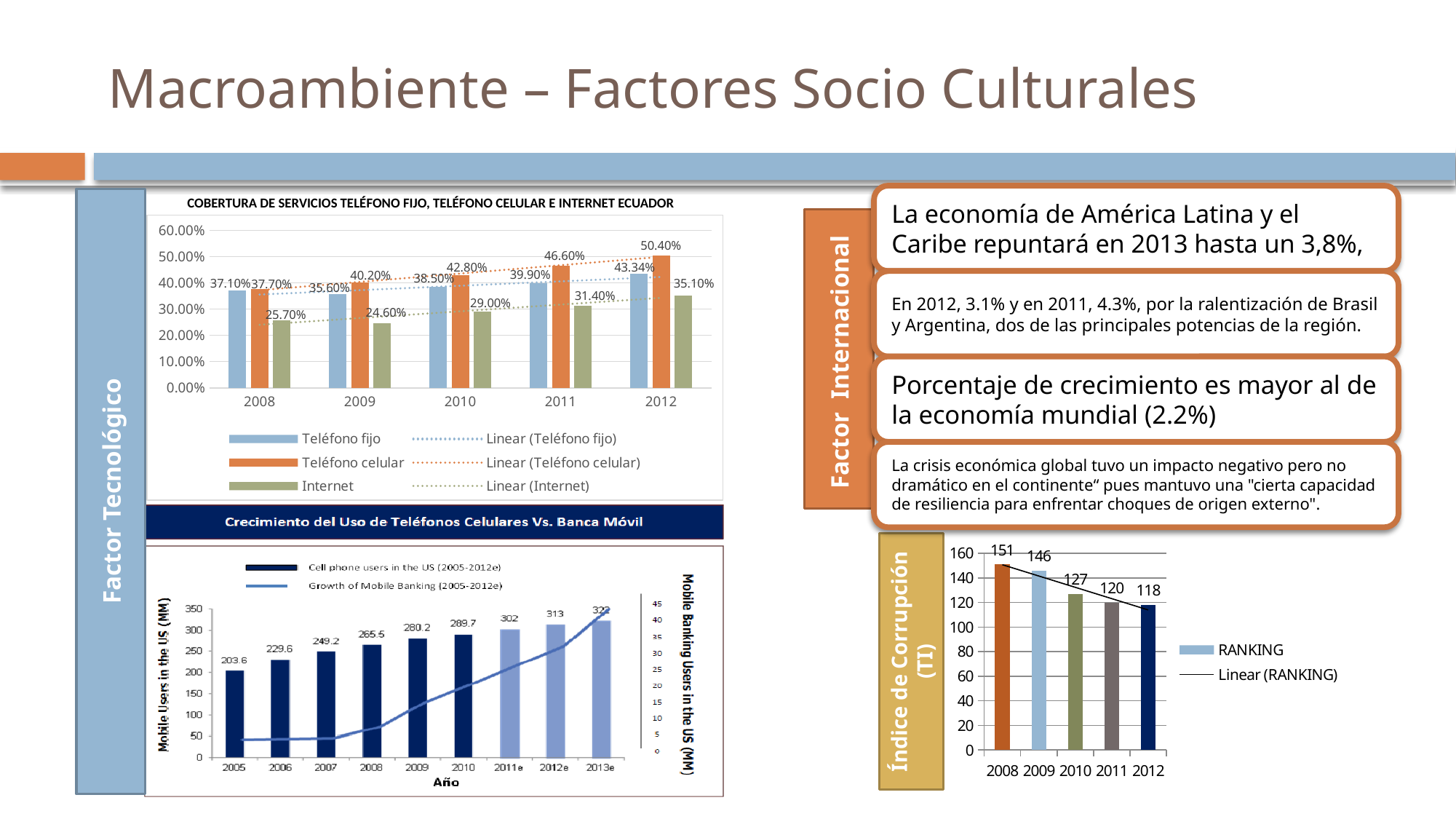
In the chart titled 'COBERTURA DE SERVICIOS TELÉFONO FIJO, TELÉFONO CELULAR E INTERNET ECUADOR', how many series does the legend list? 6 In the chart titled 'Crecimiento del Uso de Teléfonos Celulares Vs. Banca Móvil', how many years are shown on the x axis? 9 In the chart titled 'COBERTURA DE SERVICIOS TELÉFONO FIJO, TELÉFONO CELULAR E INTERNET ECUADOR', what is the value for Internet in 2009? 24.60% In the chart titled 'COBERTURA DE SERVICIOS TELÉFONO FIJO, TELÉFONO CELULAR E INTERNET ECUADOR', what is the value for Teléfono celular in 2012? 50.40% In the 'Índice de Corrupción (TI)' chart at the bottom right, what kind of chart is used for the RANKING series? bar chart In the chart titled 'COBERTURA DE SERVICIOS TELÉFONO FIJO, TELÉFONO CELULAR E INTERNET ECUADOR', does the Internet value rise or fall from 2009 to 2012? rise In the chart titled 'COBERTURA DE SERVICIOS TELÉFONO FIJO, TELÉFONO CELULAR E INTERNET ECUADOR', what is the difference between Teléfono celular and Internet in 2011? 15.20% In the 'Índice de Corrupción (TI)' chart at the bottom right, what is the RANKING value for 2010? 127 In the 'Índice de Corrupción (TI)' chart at the bottom right, which year has the lowest RANKING value? 2012 In the chart titled 'Crecimiento del Uso de Teléfonos Celulares Vs. Banca Móvil', what is the number of cell phone users in the US in 2009? 280.2 In the chart titled 'Crecimiento del Uso de Teléfonos Celulares Vs. Banca Móvil', what is the difference in cell phone users between 2013e and 2005? 118.4 In the chart titled 'COBERTURA DE SERVICIOS TELÉFONO FIJO, TELÉFONO CELULAR E INTERNET ECUADOR', in which year is the Teléfono fijo value highest? 2012